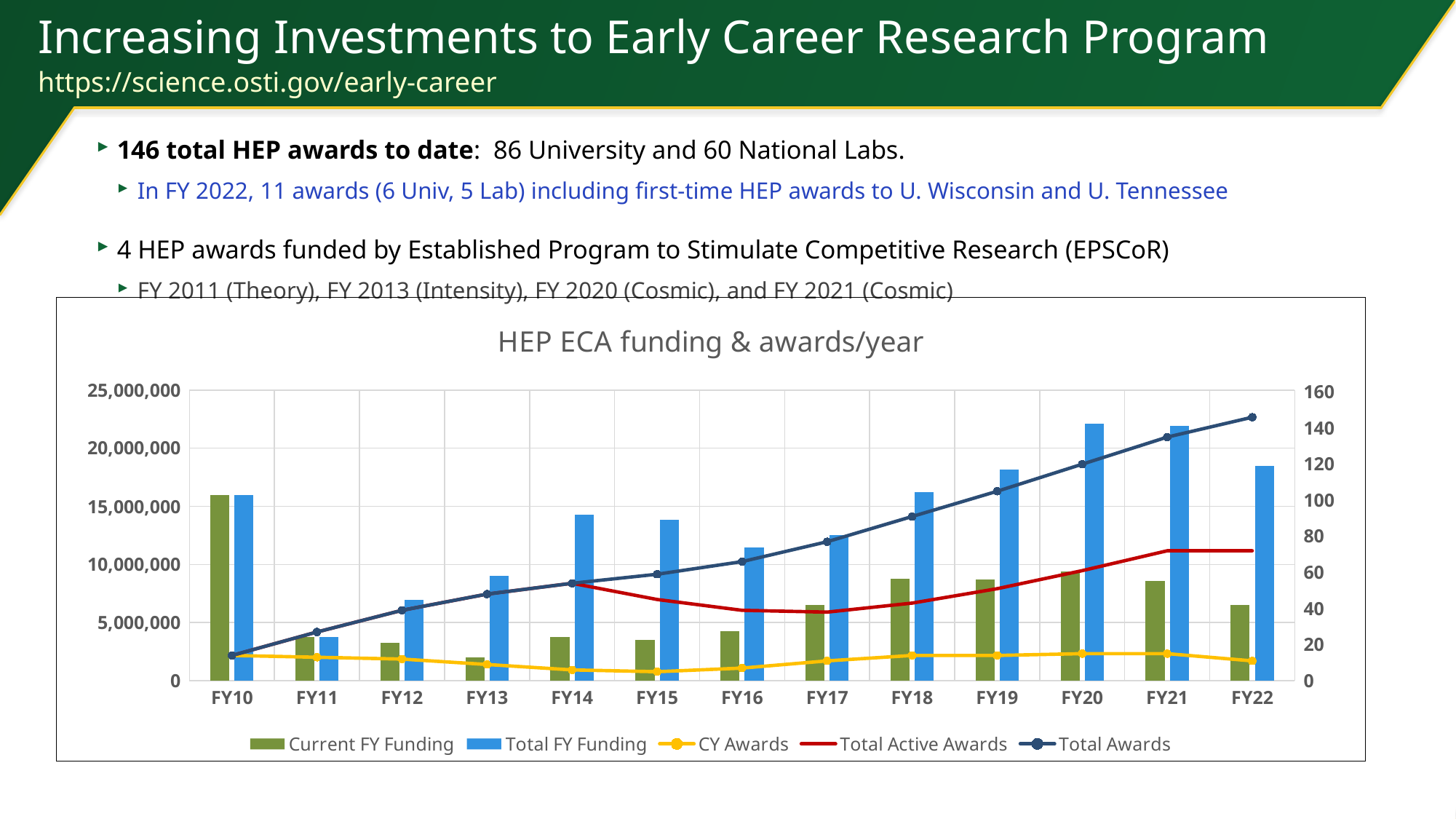
Which is larger, the Total FY Funding for FY19 or for FY16? FY19 How many series does the chart legend list? 5 How many fiscal years are shown on the x axis of the chart? 13 Which fiscal year has the lowest Current FY Funding? FY13 What is the title of the chart? HEP ECA funding & awards/year Does the Total Awards line rise or fall from FY10 to FY22? rises What colour is the Total Active Awards line in the chart? Red What kind of chart is this? Combined bar and line chart Which fiscal year has the highest Current FY Funding? FY10 Is the Total Awards value for FY16 greater or less than 80? less Which fiscal year has the lowest Total FY Funding? FY11 Is the Total FY Funding for FY22 greater or less than 15,000,000? greater